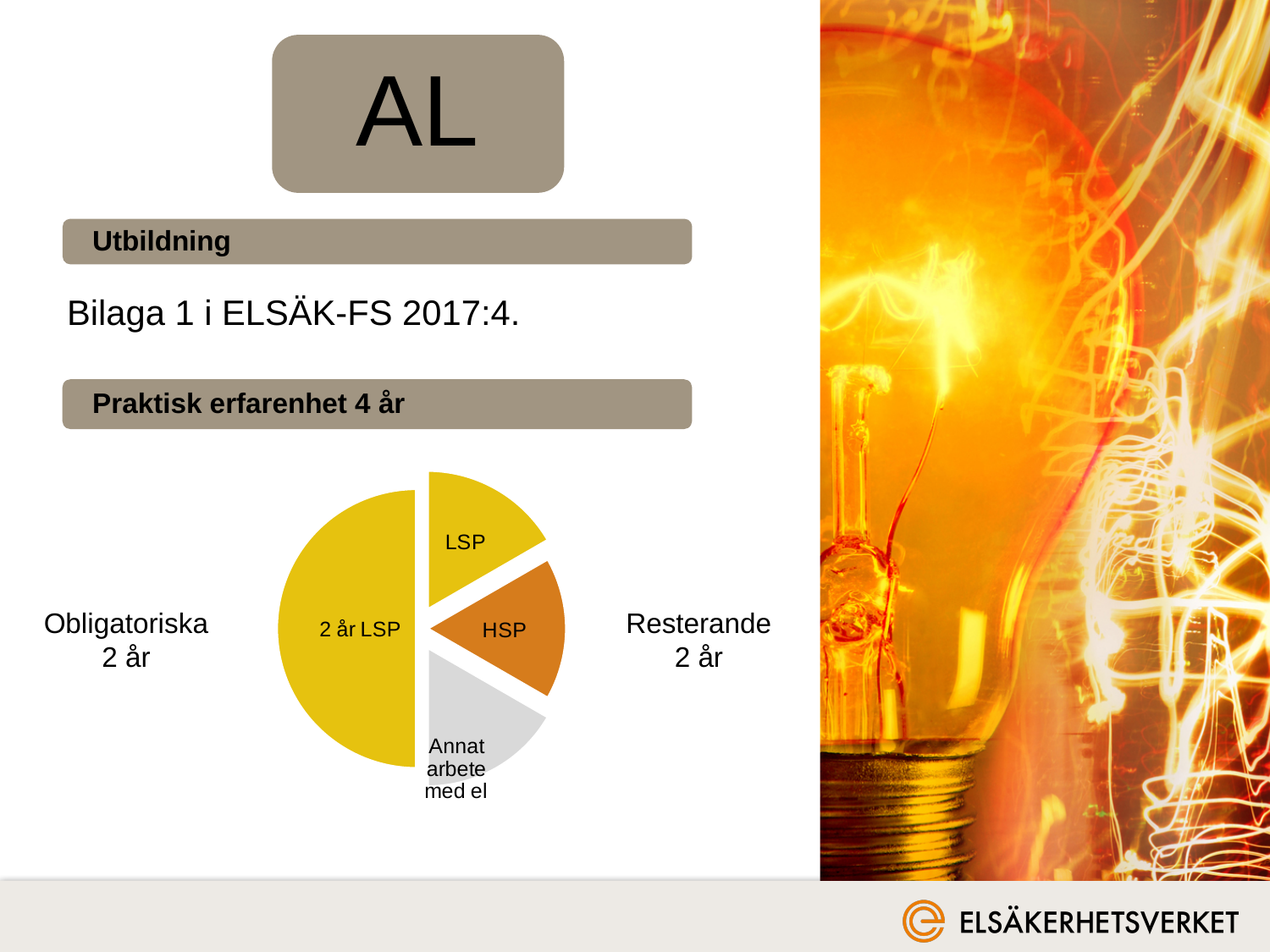
Which slice of the pie chart is the largest? 2 år LSP Which is larger in the pie chart, the "2 år LSP" slice or the "HSP" slice? 2 år LSP What kind of chart is shown on the slide? pie chart How many slices does the pie chart have? 4 What colour is the "HSP" slice in the pie chart? orange Which heading appears directly above the pie chart? Praktisk erfarenhet 4 år Which is larger in the pie chart, the "2 år LSP" slice or the "Annat arbete med el" slice? 2 år LSP